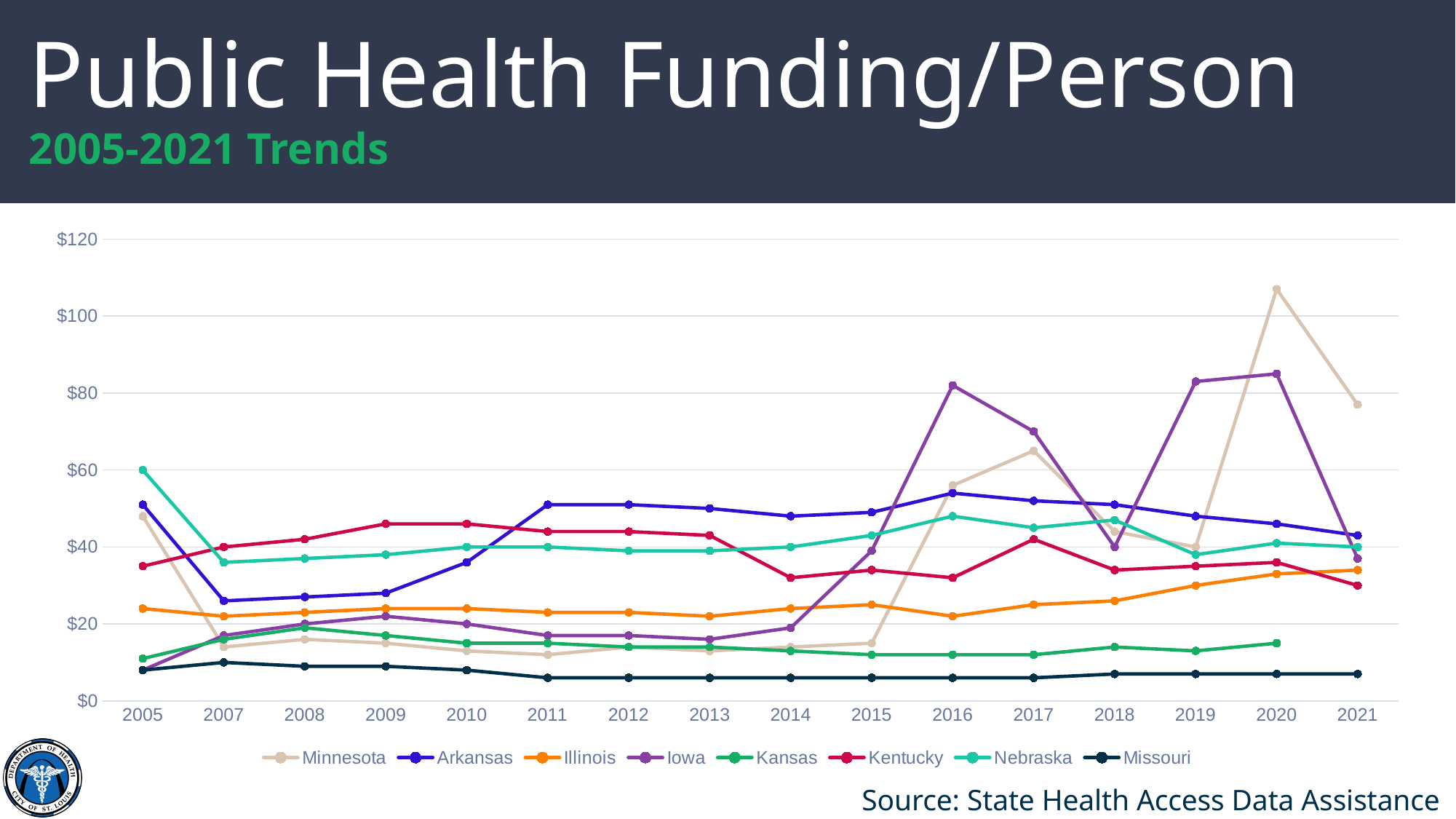
What kind of chart is shown on the slide? line chart Which series has the lowest value in 2021? Missouri Is the value for Missouri in 2021 greater or less than $20? less What is the title of the chart on the slide? Public Health Funding/Person Is the value for Nebraska in 2005 greater or less than $40? greater Is the value for Iowa in 2016 greater or less than $60? greater How many years are shown along the x axis? 16 Does the value for Illinois rise or fall from 2016 to 2021? rise How many series does the legend list? 8 In 2021, which is larger: the value for Minnesota or the value for Missouri? Minnesota Which series has the highest value in 2020? Minnesota